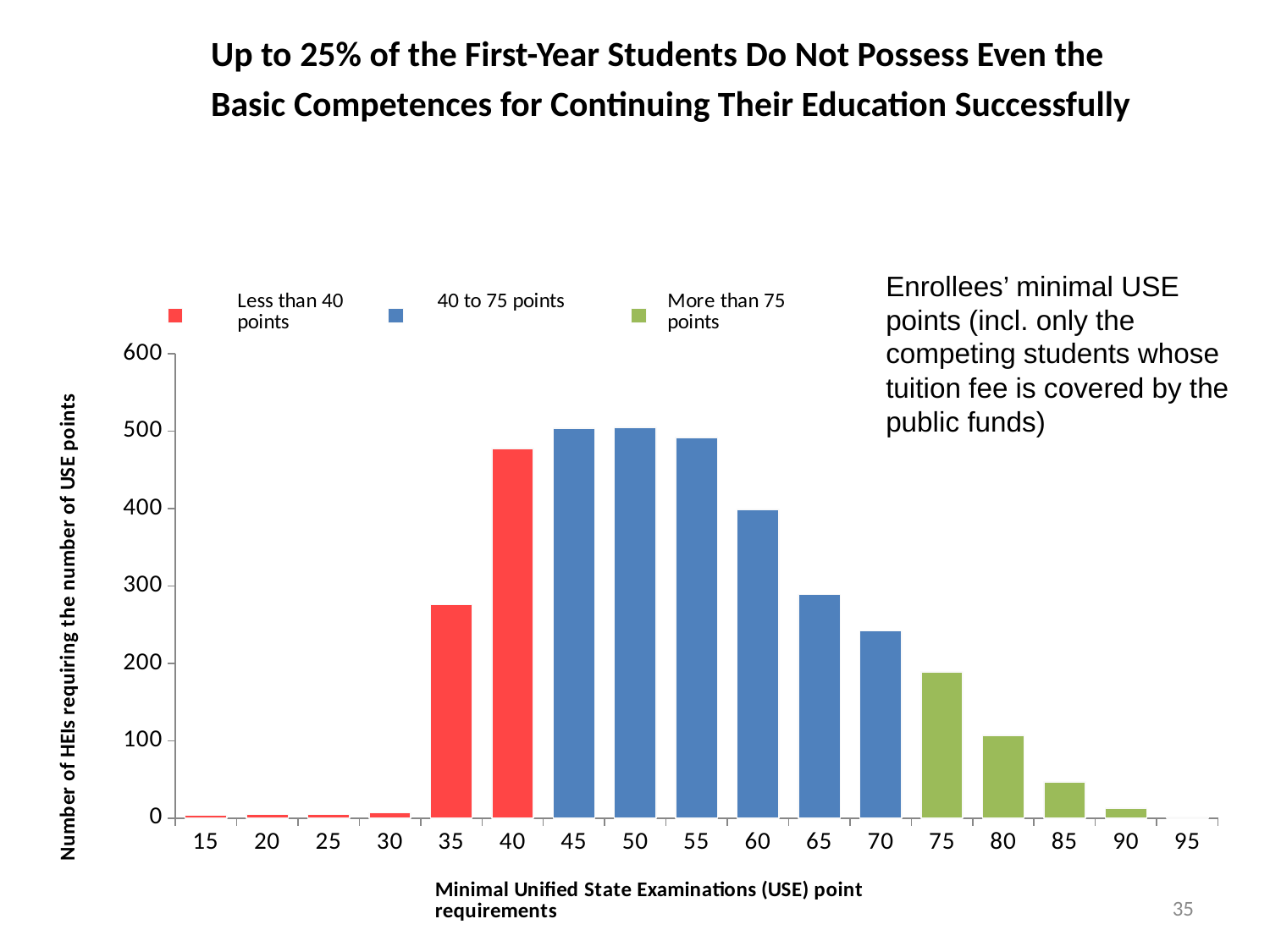
What kind of chart is shown on the slide? bar chart How many series does the legend list? 3 Is the value for 70 points greater or less than 200? greater Which has the larger value, 35 points or 40 points? 40 points Is the value for 35 points greater or less than 300? less Which has the larger value, 60 points or 70 points? 60 points Is the value for 40 points greater or less than 400? greater Do the values rise or fall along the x axis from 55 points to 90 points? fall What colour are the bars for the 'Less than 40 points' series? red How many USE point categories are shown on the x axis? 17